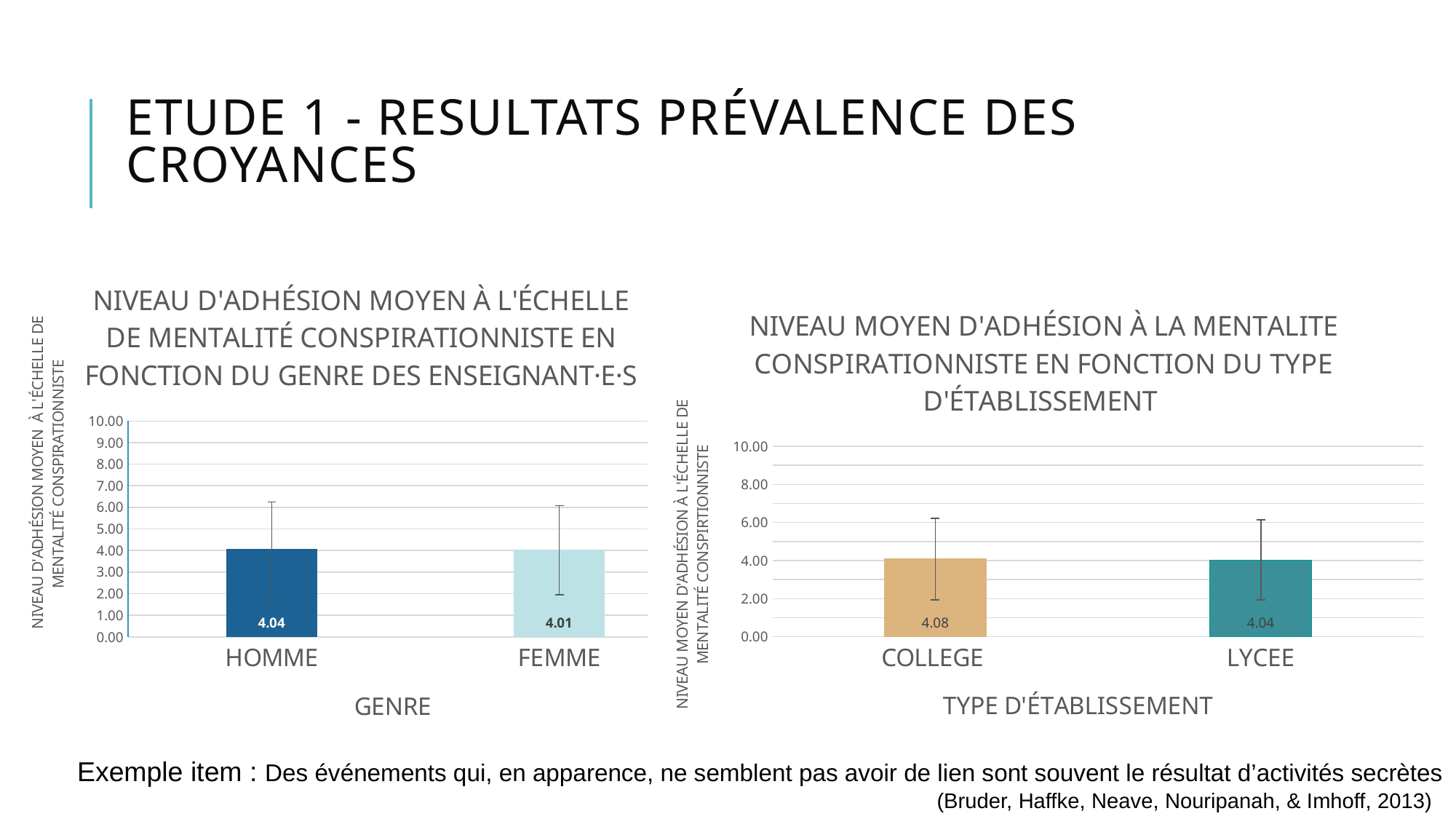
How many categories are shown in the left chart (by gender)? 2 In the right chart (by type of establishment), is the value for COLLEGE greater or less than 6.00? less What kind of chart is the right chart (by type of establishment)? bar chart In the left chart (by gender), what is the value for HOMME? 4.04 What is the x-axis title of the right chart? TYPE D'ÉTABLISSEMENT In the left chart (by gender), what is the difference between the values for HOMME and FEMME? 0.03 In the right chart (by type of establishment), what is the value for LYCEE? 4.04 In the left chart (by gender), what is the value for FEMME? 4.01 In the right chart (by type of establishment), what is the difference between the values for COLLEGE and LYCEE? 0.04 In the right chart (by type of establishment), what is the value for COLLEGE? 4.08 In the left chart (by gender), which category has the higher value according to the data labels? HOMME In the right chart (by type of establishment), which category has the lower value according to the data labels? LYCEE